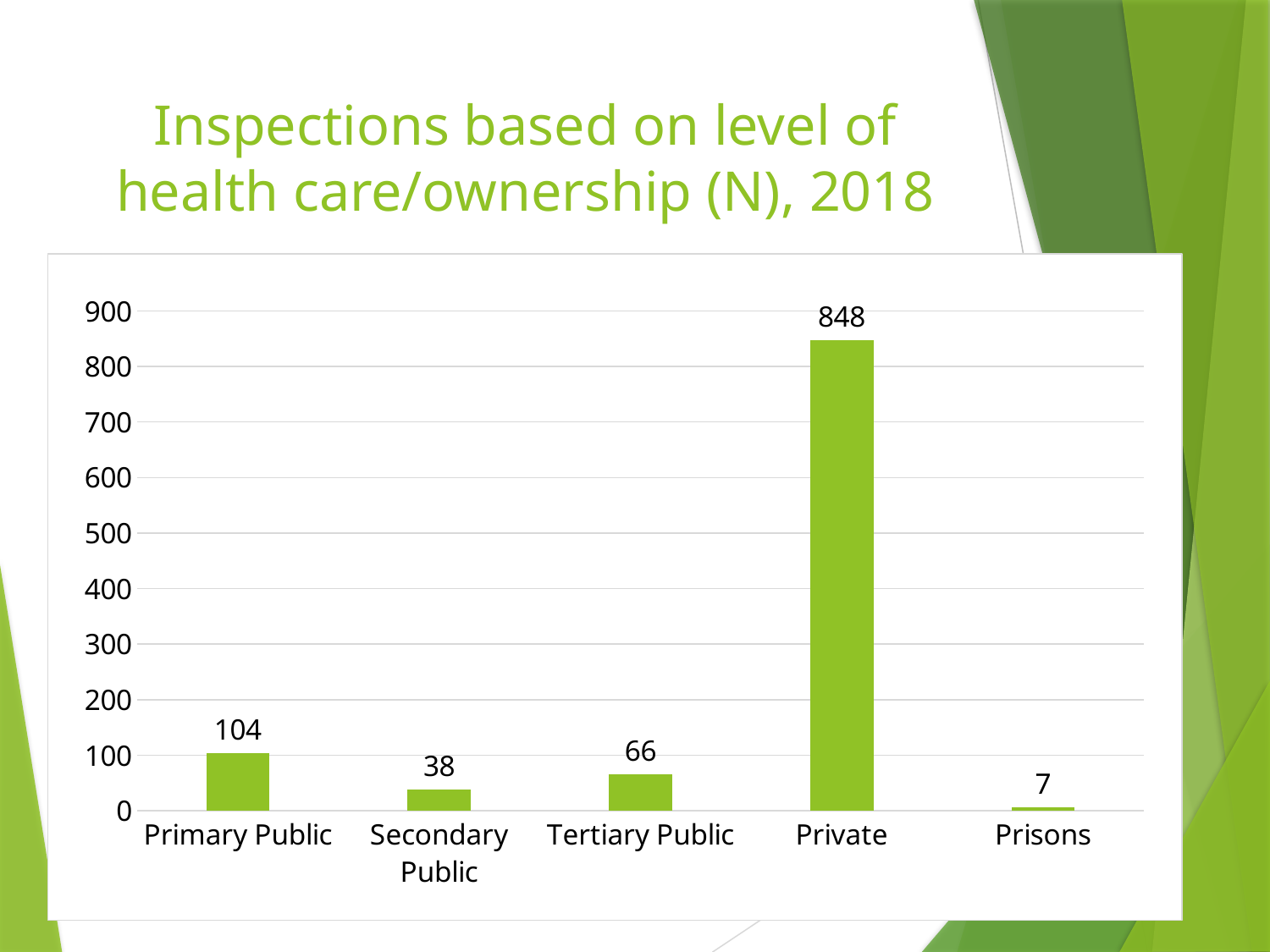
What is the value shown for Prisons? 7 What is the title of the slide? Inspections based on level of health care/ownership (N), 2018 How many inspections were carried out for Private facilities? 848 What is the difference between the values for Tertiary Public and Secondary Public? 28 Which category has the highest number of inspections? Private What kind of chart is shown on the slide? Bar chart Which category has the lowest number of inspections? Prisons Which is larger, the value for Primary Public or the value for Tertiary Public? Primary Public What is the difference between the values for Private and Primary Public? 744 What is the value shown for Primary Public? 104 What is the value shown for Secondary Public? 38 How many categories are shown on the x axis? 5